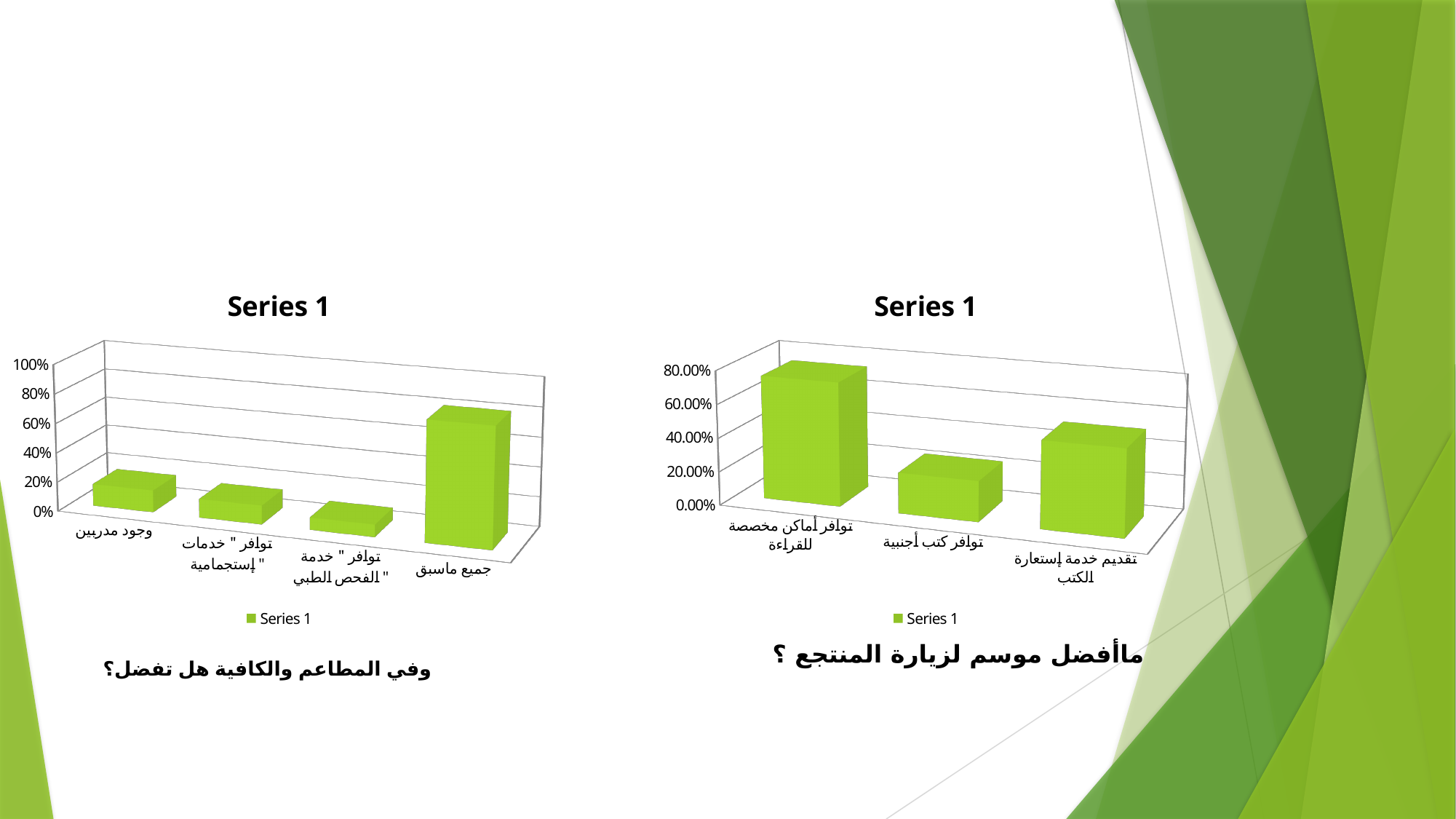
In the left chart, is the value for جميع ماسبق greater or less than 40%? greater In the right chart, which is larger: the value for تقديم خدمة إستعارة الكتب or the value for توافر كتب أجنبية? تقديم خدمة إستعارة الكتب In the right chart, is the value for توافر أماكن مخصصة للقراءة greater or less than 40.00%? greater In the left chart, is the value for وجود مدربين greater or less than 40%? less How many categories does the right chart show? 3 In the left chart, which category has the highest value? جميع ماسبق How many series does the legend of the right chart list? 1 How many categories does the left chart show? 4 In the right chart, which category has the highest value? توافر أماكن مخصصة للقراءة In the left chart, which category has the lowest value? توافر " خدمة الفحص الطبي " What kind of chart is the left chart on the slide? bar chart In the right chart, which category has the lowest value? توافر كتب أجنبية